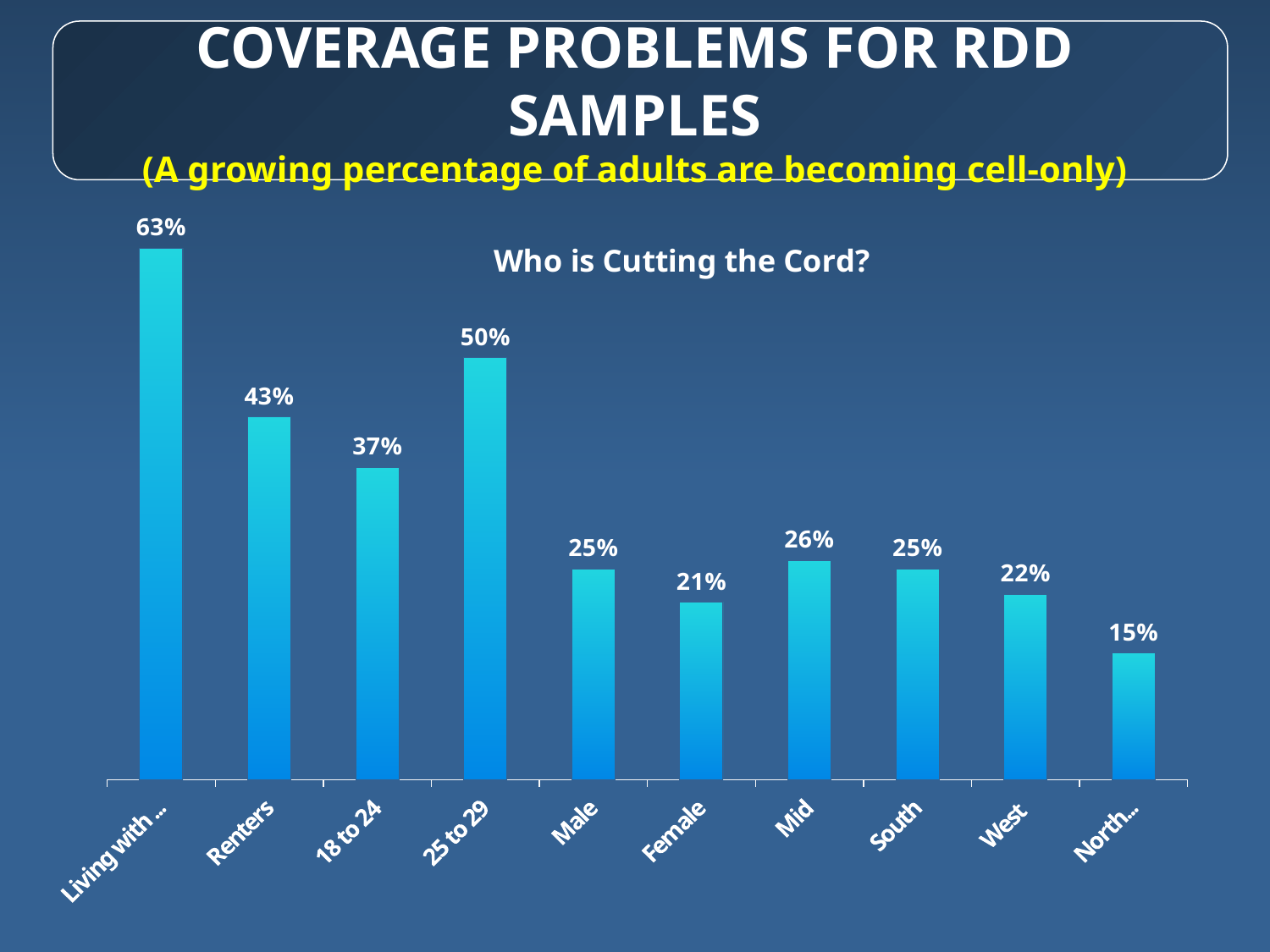
What is the value for West? 22% What kind of chart is shown on the slide? Bar chart What is the difference between the values for Male and Female? 4% What is the lowest value shown on the chart? 15% What is the title of the chart? Who is Cutting the Cord? What is the value for Renters? 43% How many categories are shown on the chart? 10 What is the highest value shown on the chart? 63% What is the value for 25 to 29? 50% What is the value for Female? 21% Which has a larger value, Renters or 18 to 24? Renters What is the difference between the values for 25 to 29 and 18 to 24? 13%